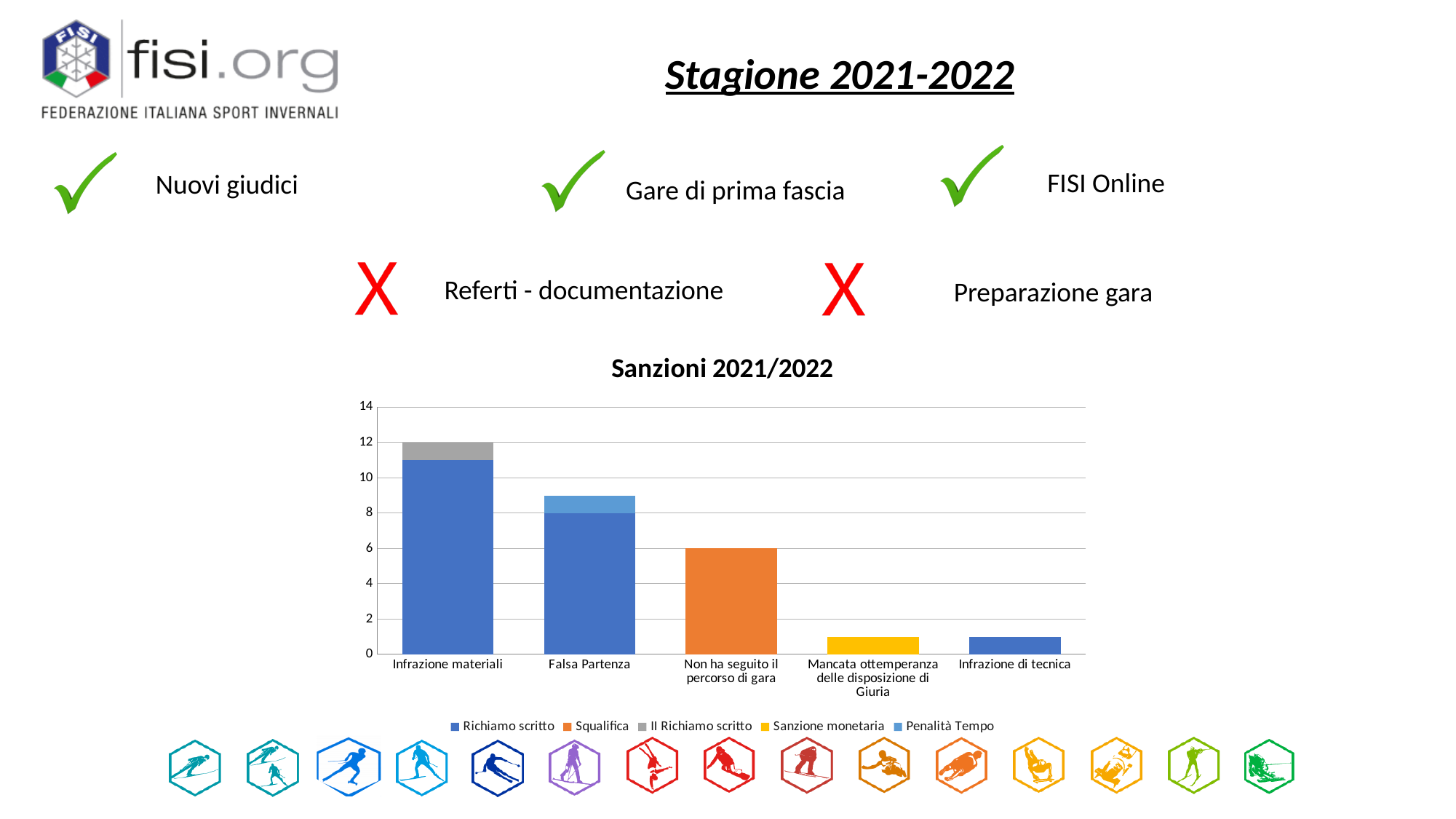
Is the total for 'Falsa Partenza' greater or less than 8? greater How many categories are shown on the x axis of the 'Sanzioni 2021/2022' chart? 5 What is the total height of the stacked bar for 'Infrazione materiali'? 12 Which category has the tallest bar in the 'Sanzioni 2021/2022' chart? Infrazione materiali Which is larger: the bar for 'Falsa Partenza' or the bar for 'Non ha seguito il percorso di gara'? Falsa Partenza Is the value for 'Mancata ottemperanza delle disposizione di Giuria' greater or less than 2? less How many series does the legend of the 'Sanzioni 2021/2022' chart list? 5 Which series is shown in orange in the 'Sanzioni 2021/2022' chart? Squalifica Which series is shown in yellow in the 'Sanzioni 2021/2022' chart? Sanzione monetaria Do the bar totals generally rise or fall from left to right across the 'Sanzioni 2021/2022' chart? fall What is the value of the bar for 'Non ha seguito il percorso di gara'? 6 What kind of chart is shown under the title 'Sanzioni 2021/2022'? bar chart